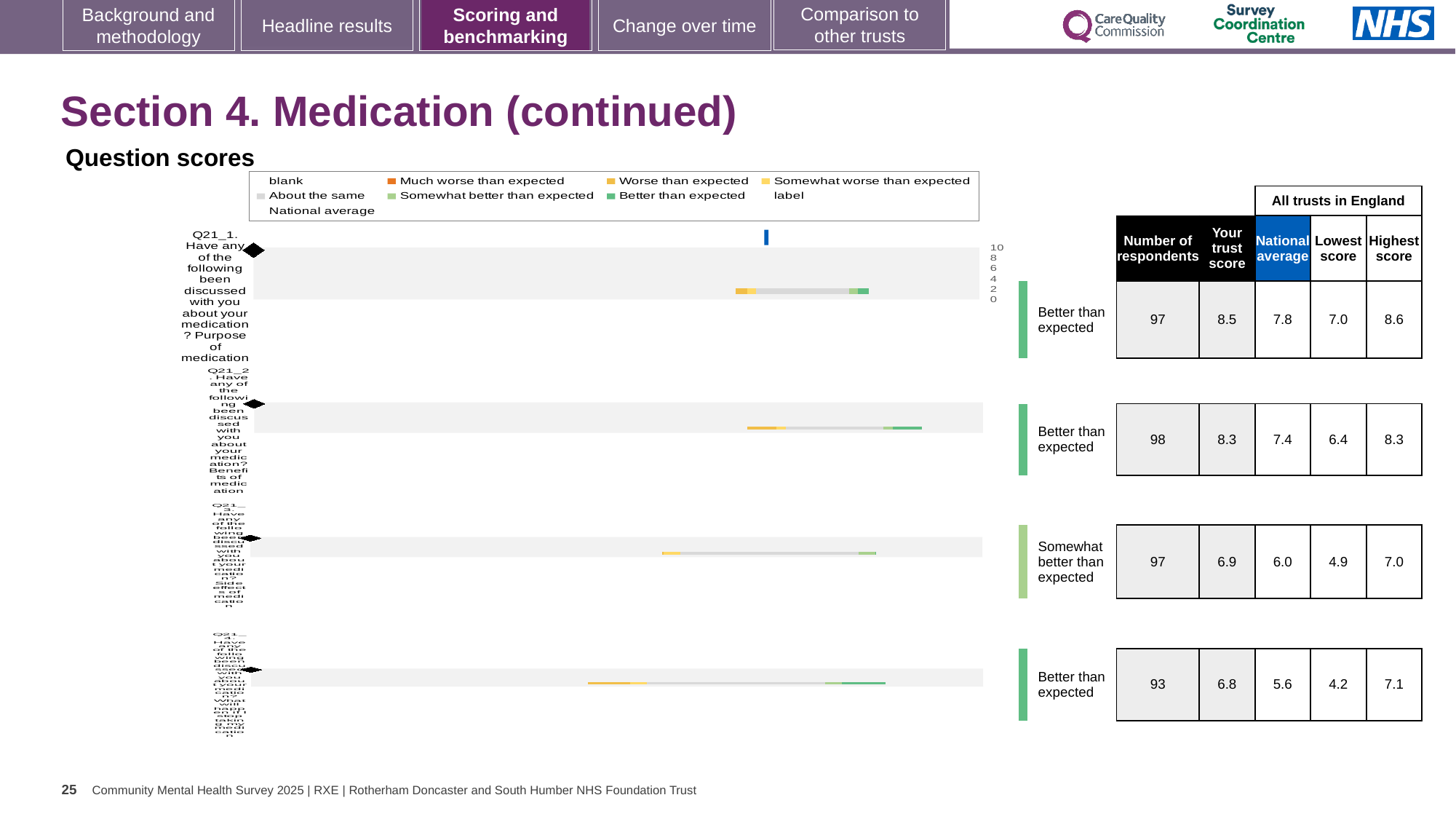
How many question categories (bars) are plotted in the Question scores chart? 4 What is the difference between the trust score and the national average for Q21_4? 1.2 Which question has the lowest national average? Q21_4 What is the highest tick value shown on the score axis of the Question scores chart? 10 How many entries does the legend of the Question scores chart list? 9 What is the national average for Q21_4 (What will happen if I stop taking medication)? 5.6 Which question has the highest trust score? Q21_1 What kind of chart is shown under "Question scores"? bar chart Is the trust score for Q21_3 (Side effects of medication) larger or smaller than the national average for Q21_3? larger What benchmark category is shown for Q21_3 (Side effects of medication)? Somewhat better than expected How many respondents answered Q21_2 (Benefits of medication)? 98 What is the trust score for Q21_1 (Purpose of medication)? 8.5